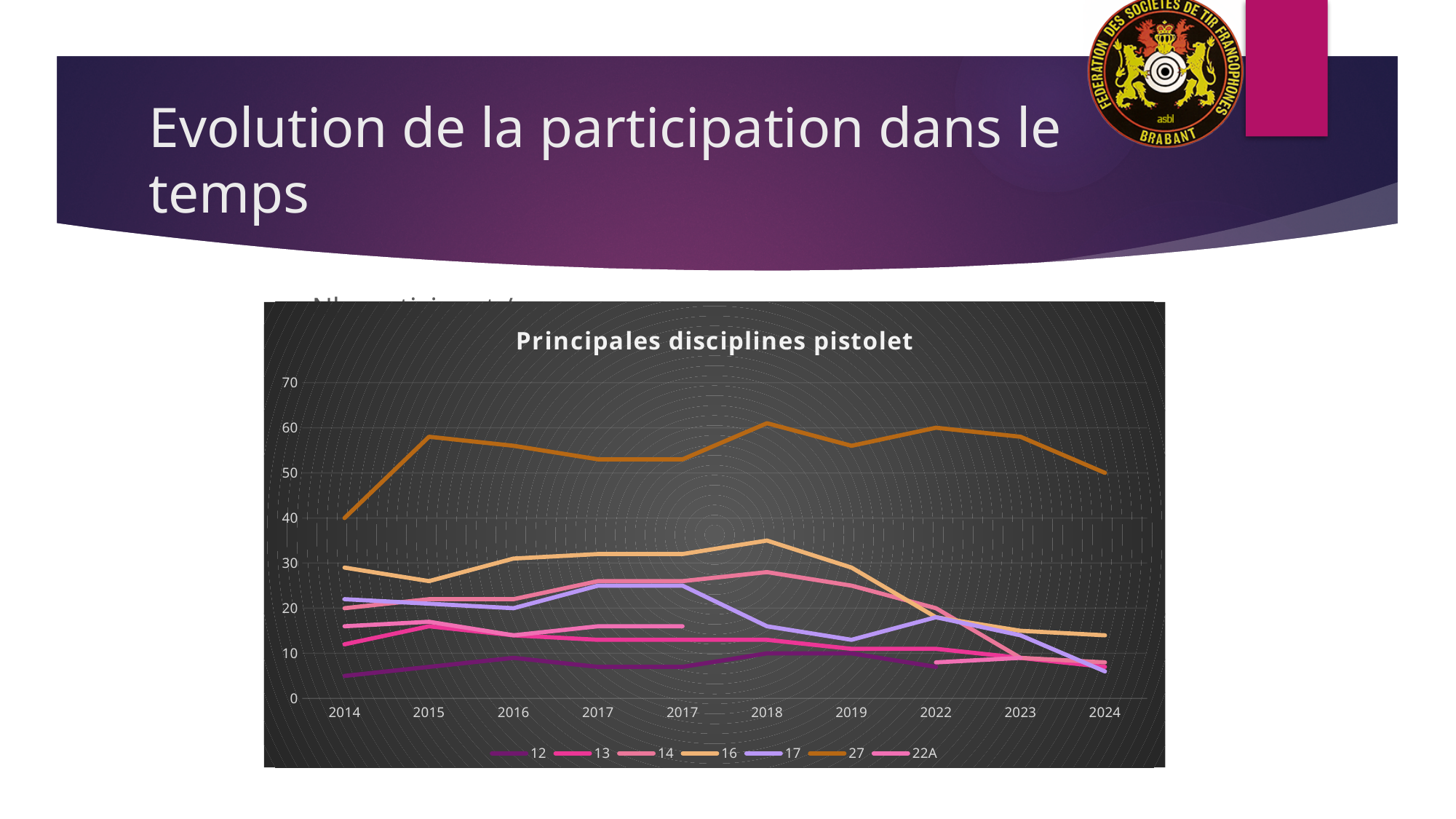
In 2014, which series has the larger value, 27 or 16? 27 Is the value for series 27 in 2024 greater or less than 40? greater How many series does the legend list? 7 Which series has the highest value in 2018? 27 Which series has the lowest value in 2014? 12 Is the value for series 16 in 2018 greater or less than 30? greater Does series 16 rise or fall from 2018 to 2024? fall How many points are there along the x axis? 10 Is the value for series 27 in 2018 greater or less than 50? greater What kind of chart is shown on the slide? line chart What is the title of the chart? Principales disciplines pistolet